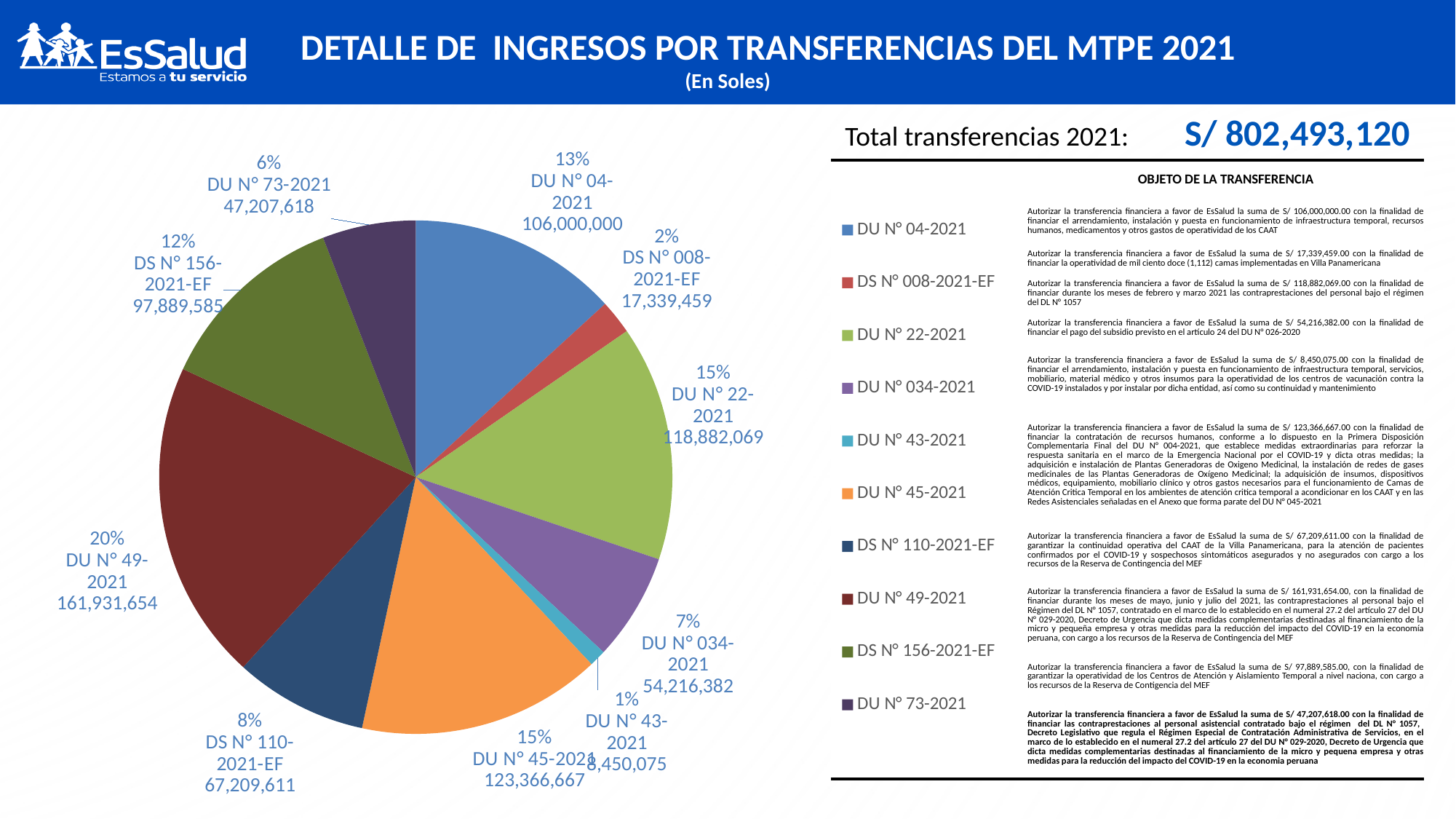
How many slices does the pie chart have? 10 What is the value shown for DS N° 008-2021-EF? 17,339,459 What is the difference between the values for DU N° 22-2021 and DU N° 04-2021? 12,882,069 What kind of chart is shown on the slide? pie chart What share of the pie does DU N° 034-2021 represent? 7% Which category has the smallest slice of the pie? DU N° 43-2021 What share of the pie does DS N° 156-2021-EF represent? 12% What total for transferencias 2021 is shown on the slide? S/ 802,493,120 Which is larger, the value for DS N° 110-2021-EF or the value for DU N° 73-2021? DS N° 110-2021-EF What is the value shown for DU N° 49-2021? 161,931,654 What is the value shown for DU N° 45-2021? 123,366,667 Which category has the largest slice of the pie? DU N° 49-2021